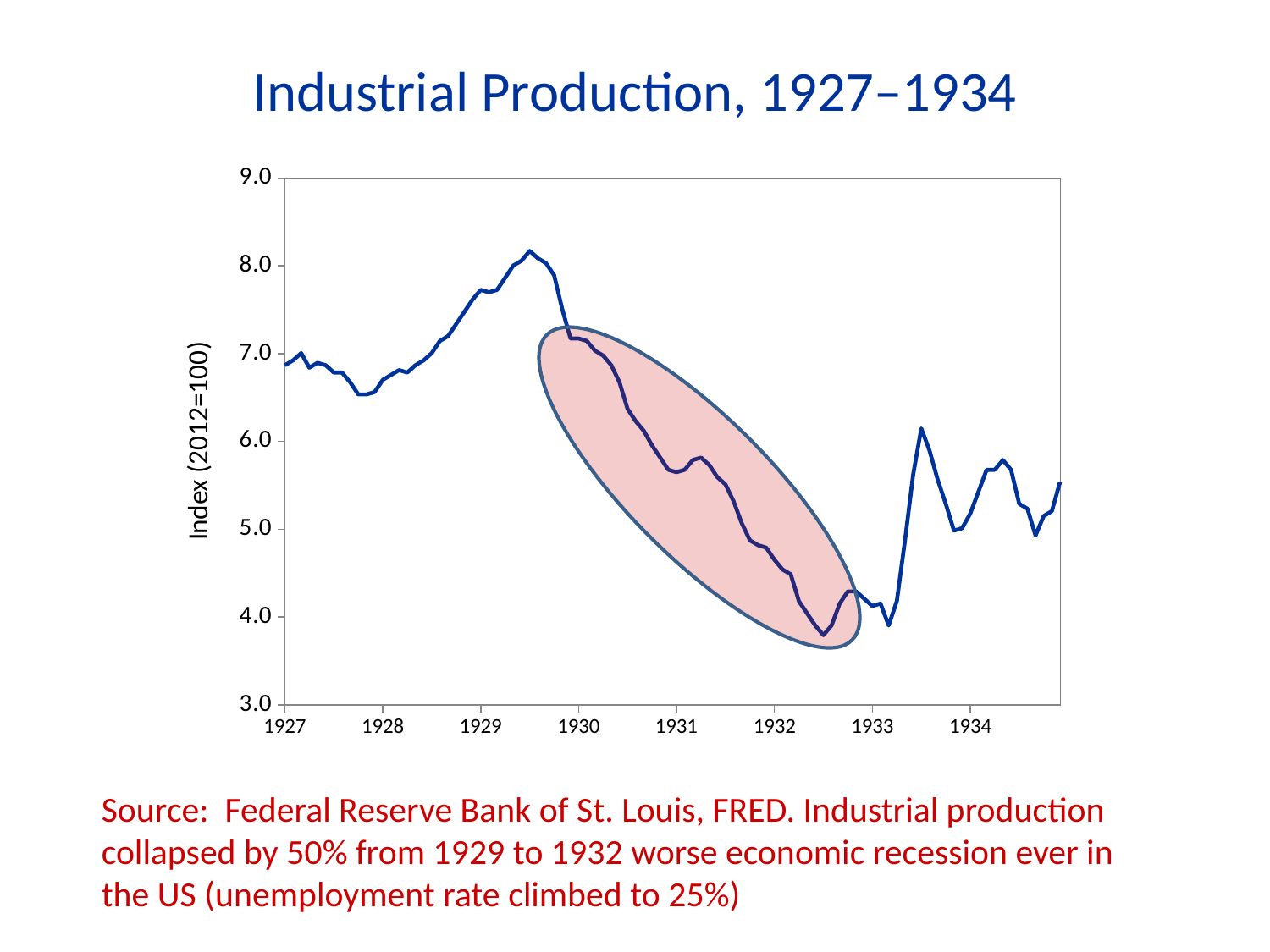
Is the peak value of the index in 1929 greater or less than 7.0? greater Is the value of the index at the start of 1931 greater or less than 6.0? less Does the industrial production index rise or fall between the start of 1933 and mid-1933? Rise Which is larger, the index value at the start of 1927 or at the end of 1934? Start of 1927 In which year does the industrial production index reach its highest point? 1929 What kind of chart is shown on the slide? Line chart Which is larger, the index value at the start of 1931 or at the start of 1933? Start of 1931 Is the value of the index at the start of 1932 greater or less than 5.0? less What is the label on the vertical axis of the chart? Index (2012=100) Does the industrial production index rise or fall between 1929 and 1932? Fall What is the title of the chart? Industrial Production, 1927–1934